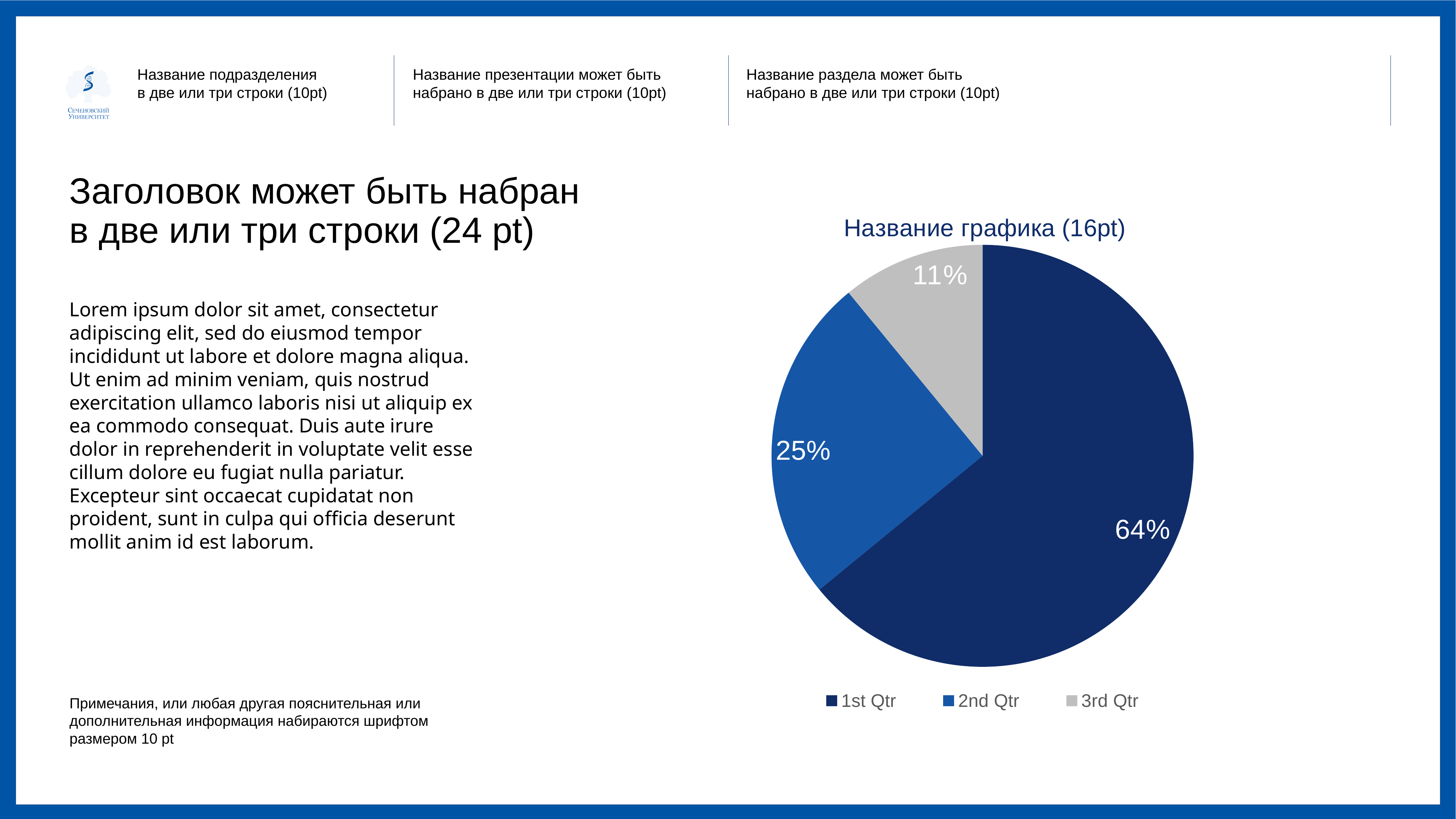
What share of the pie does 1st Qtr have? 64% What colour is the 3rd Qtr slice? grey Which category has the largest slice of the pie? 1st Qtr Which category has the smallest slice of the pie? 3rd Qtr What share of the pie does 2nd Qtr have? 25% What is the difference in percentage points between the 1st Qtr and 2nd Qtr slices? 39 What kind of chart is shown on the slide? pie chart What share of the pie does 3rd Qtr have? 11% Which slice is larger, 2nd Qtr or 3rd Qtr? 2nd Qtr How many entries does the legend list? 3 How many slices does the pie chart have? 3 What is the title of the chart? Название графика (16pt)